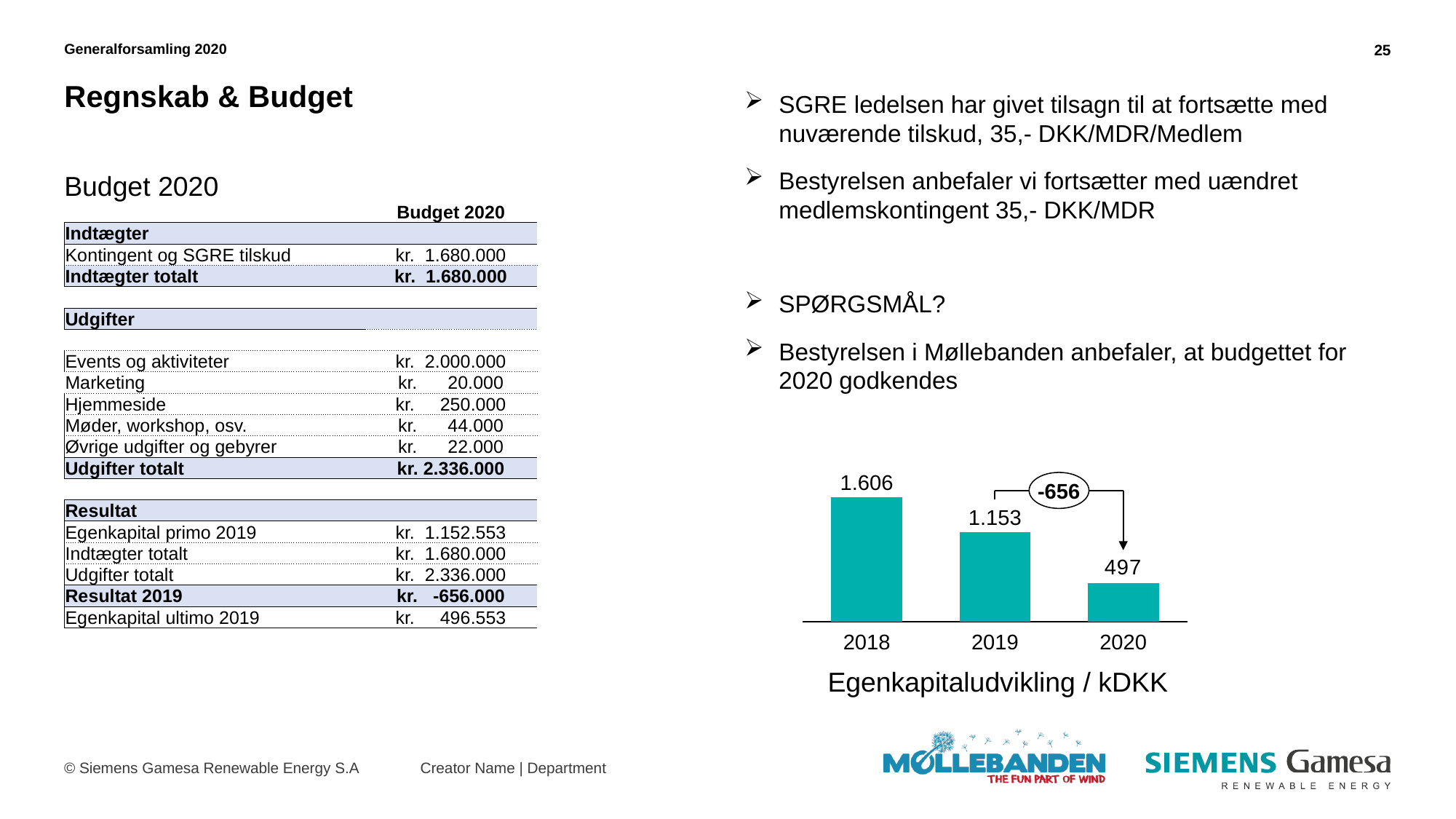
What is the value for 2018 in the Egenkapitaludvikling chart? 1.606 What type of chart is shown on the slide? bar chart Do the values in the Egenkapitaludvikling chart rise or fall from 2018 to 2020? fall What is the difference between the 2018 and 2019 values in the Egenkapitaludvikling chart? 453 What is the title of the bar chart on the slide? Egenkapitaludvikling / kDKK Which year has the lowest value in the Egenkapitaludvikling chart? 2020 What is the difference between the 2019 and 2020 values in the Egenkapitaludvikling chart? 656 How many bars are shown in the Egenkapitaludvikling chart? 3 Which year has the highest value in the Egenkapitaludvikling chart? 2018 What is the value for 2020 in the Egenkapitaludvikling chart? 497 Which is larger in the Egenkapitaludvikling chart, the value for 2018 or the value for 2020? 2018 What is the value for 2019 in the Egenkapitaludvikling chart? 1.153